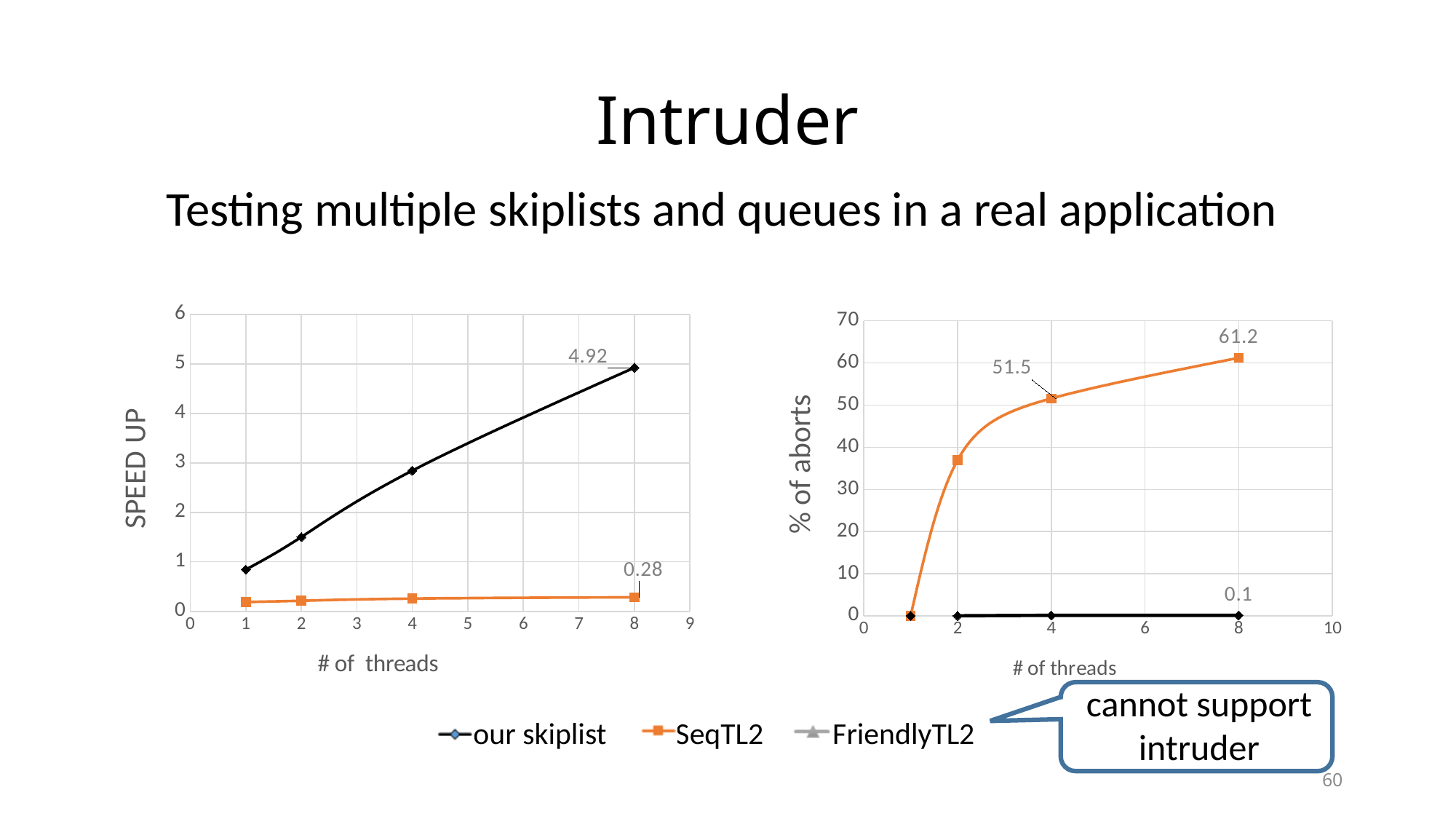
In the right chart (% of aborts), is the percentage of aborts for SeqTL2 at 2 threads greater or less than 30? greater In the left chart (SPEED UP), what is the speed up for our skiplist at 8 threads? 4.92 In the right chart (% of aborts), what is the percentage of aborts for our skiplist at 8 threads? 0.1 In the right chart (% of aborts), by how much does the SeqTL2 abort percentage increase from 4 threads to 8 threads? 9.7 In the left chart (SPEED UP), what is the speed up for SeqTL2 at 8 threads? 0.28 In the right chart (% of aborts), what is the percentage of aborts for SeqTL2 at 4 threads? 51.5 In the left chart (SPEED UP), which series has the higher speed up at 8 threads, our skiplist or SeqTL2? our skiplist How many series does the legend list? 3 In the left chart (SPEED UP), is the speed up for our skiplist at 4 threads greater or less than 2? greater In the left chart (SPEED UP), what is the difference between the speed up of our skiplist and SeqTL2 at 8 threads? 4.64 In the left chart (SPEED UP), does the speed up for our skiplist rise or fall as the number of threads increases? rises In the right chart (% of aborts), what is the percentage of aborts for SeqTL2 at 8 threads? 61.2